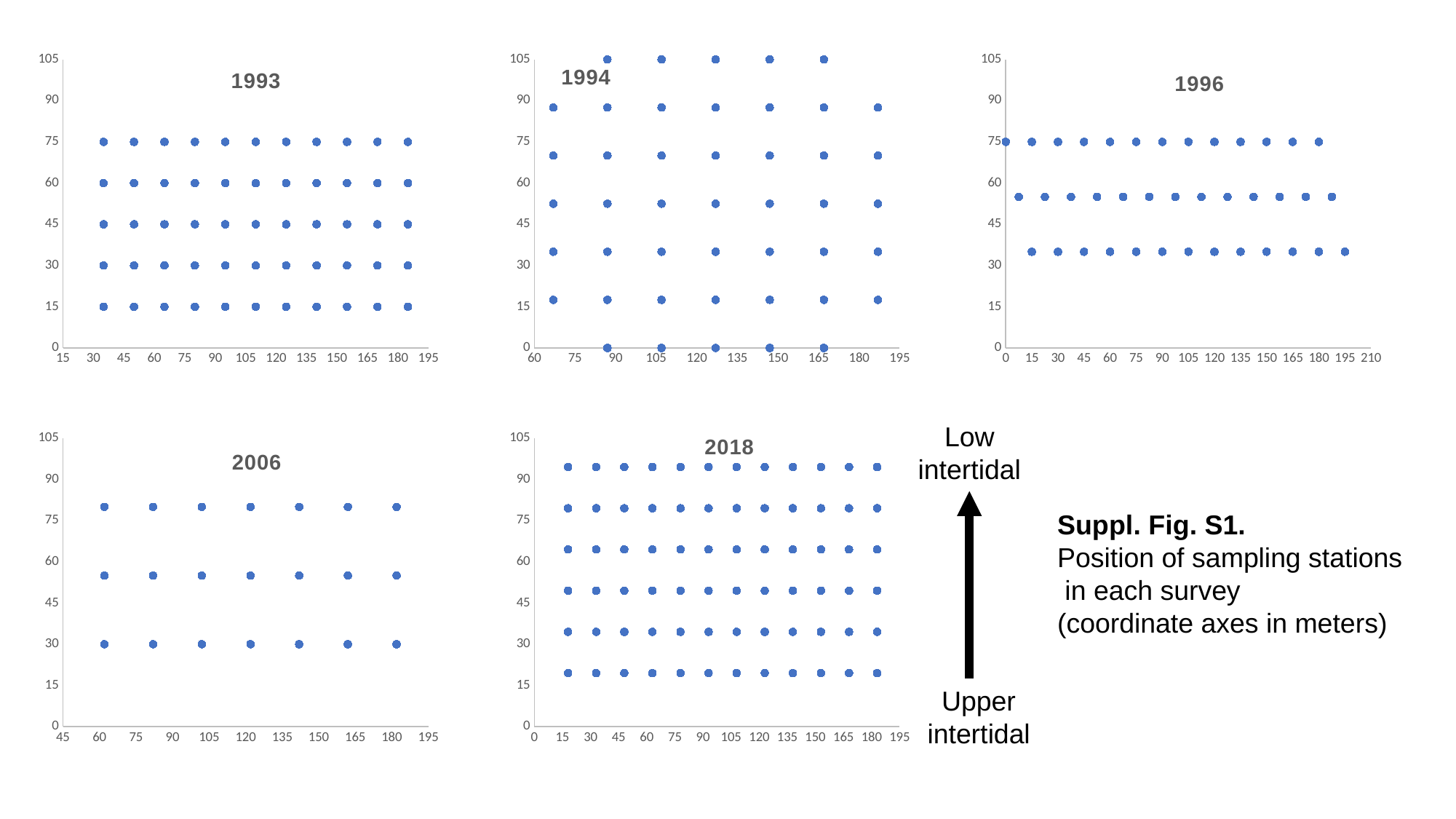
In the 2018 chart, how many horizontal rows of points are there? 6 Which chart has the most plotted points? 2018 In the 2006 chart, how many points are plotted? 21 In the 1996 chart, how many horizontal rows of points are there? 3 In the 1996 chart, is the y value of the lowest row of points greater or less than 30? greater Which chart has the fewest plotted points? 2006 According to the caption, what unit are the coordinate axes in? meters In the 1994 chart, what is the y value of the bottom row of points? 0 What kind of chart is the 1993 chart? scatter chart In the 1994 chart, what is the y value of the topmost row of points? 105